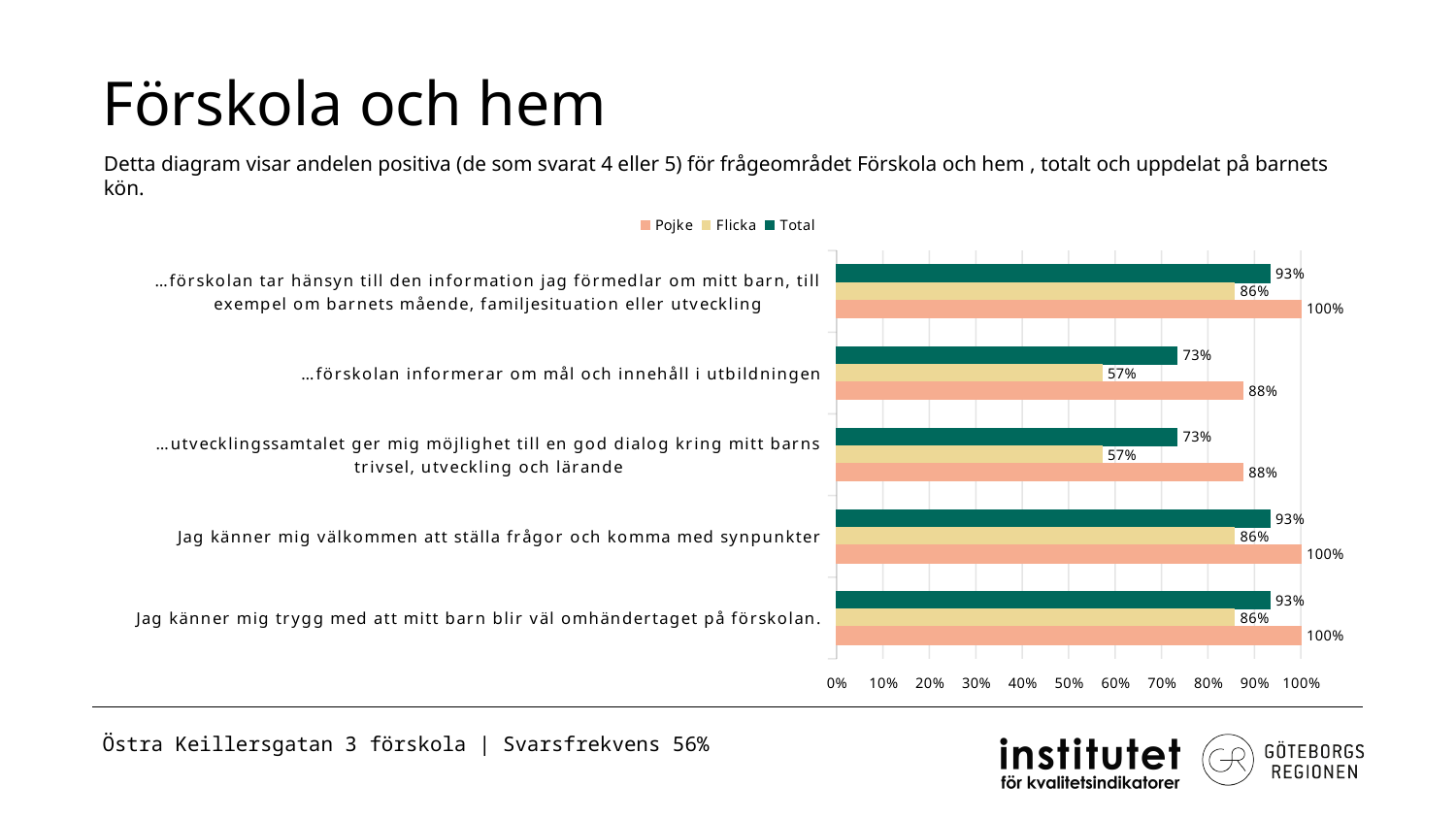
Which legend entry is shown in green? Total What is the difference between the Pojke and Flicka values for "…utvecklingssamtalet ger mig möjlighet till en god dialog kring mitt barns trivsel, utveckling och lärande"? 31% Which is larger for "Jag känner mig välkommen att ställa frågor och komma med synpunkter": the Total value or the Flicka value? Total Is the Flicka value for "…förskolan informerar om mål och innehåll i utbildningen" greater or less than 60%? less What is the Flicka value for "Jag känner mig trygg med att mitt barn blir väl omhändertaget på förskolan."? 86% How many categories (statements) are plotted in the chart? 5 What is the Pojke value for "…förskolan informerar om mål och innehåll i utbildningen"? 88% What type of chart is shown on the slide? bar chart Which series has the lowest value for "…förskolan informerar om mål och innehåll i utbildningen"? Flicka What is the difference between the Total values for "…förskolan tar hänsyn till den information jag förmedlar om mitt barn, till exempel om barnets mående, familjesituation eller utveckling" and "…förskolan informerar om mål och innehåll i utbildningen"? 20% What is the Total value for "…utvecklingssamtalet ger mig möjlighet till en god dialog kring mitt barns trivsel, utveckling och lärande"? 73% How many series does the legend list? 3